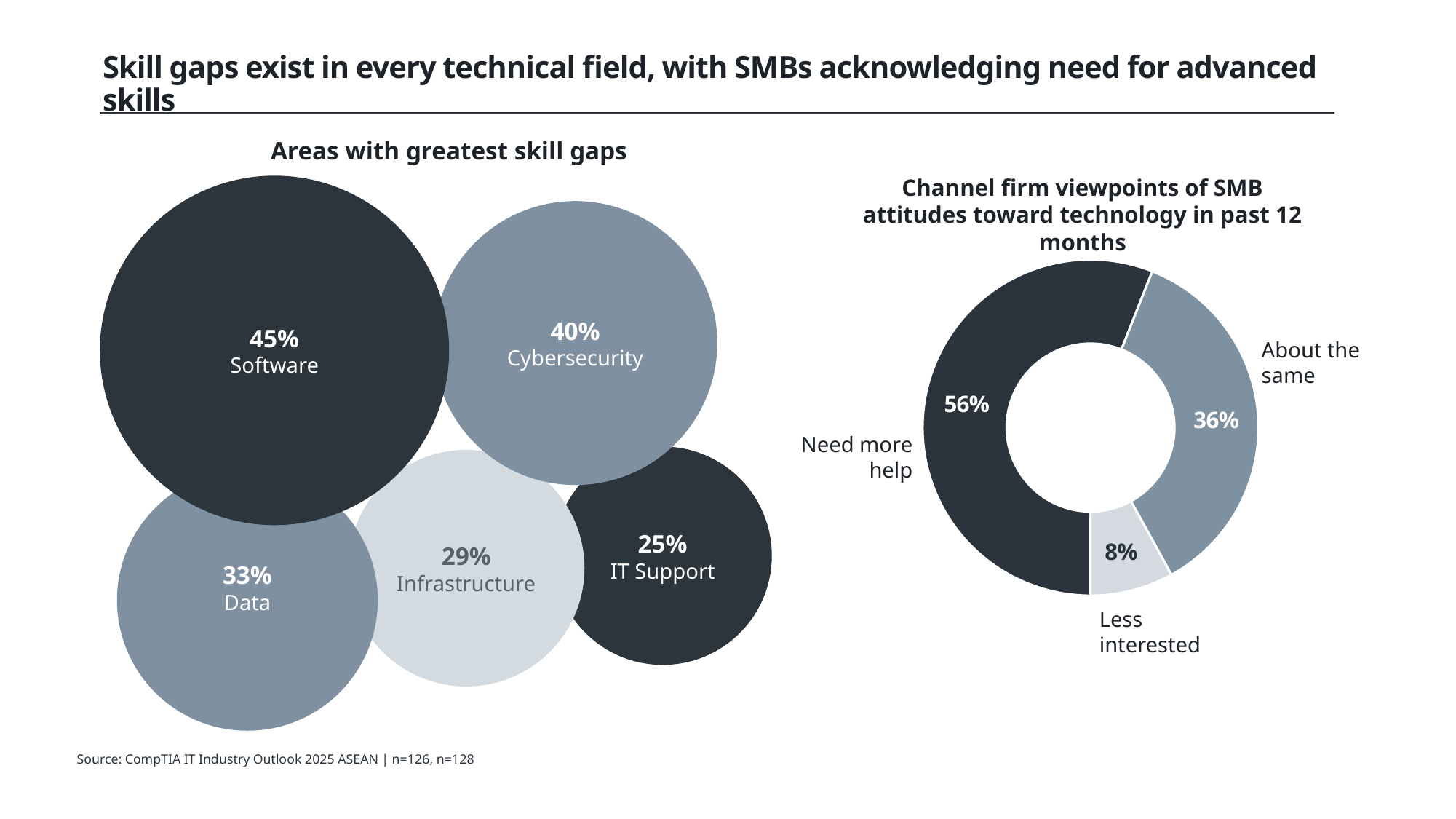
In the 'Channel firm viewpoints of SMB attitudes toward technology in past 12 months' chart, what is the difference between 'Need more help' and 'About the same'? 20% In the 'Areas with greatest skill gaps' chart, what is the difference between the values for Cybersecurity and Data? 7% In the 'Areas with greatest skill gaps' chart, which area has the highest value? Software In the 'Areas with greatest skill gaps' chart, what is the value for Software? 45% What kind of chart is the 'Channel firm viewpoints of SMB attitudes toward technology in past 12 months' chart? Doughnut chart In the 'Channel firm viewpoints of SMB attitudes toward technology in past 12 months' chart, what is the value for 'Need more help'? 56% In the 'Areas with greatest skill gaps' chart, which area has the lowest value? IT Support In the 'Areas with greatest skill gaps' chart, which is larger, the value for Data or the value for Infrastructure? Data In the 'Channel firm viewpoints of SMB attitudes toward technology in past 12 months' chart, which category has the largest share? Need more help How many areas are shown in the 'Areas with greatest skill gaps' chart? 5 In the 'Areas with greatest skill gaps' chart, what is the value for Infrastructure? 29% In the 'Channel firm viewpoints of SMB attitudes toward technology in past 12 months' chart, what is the value for 'Less interested'? 8%